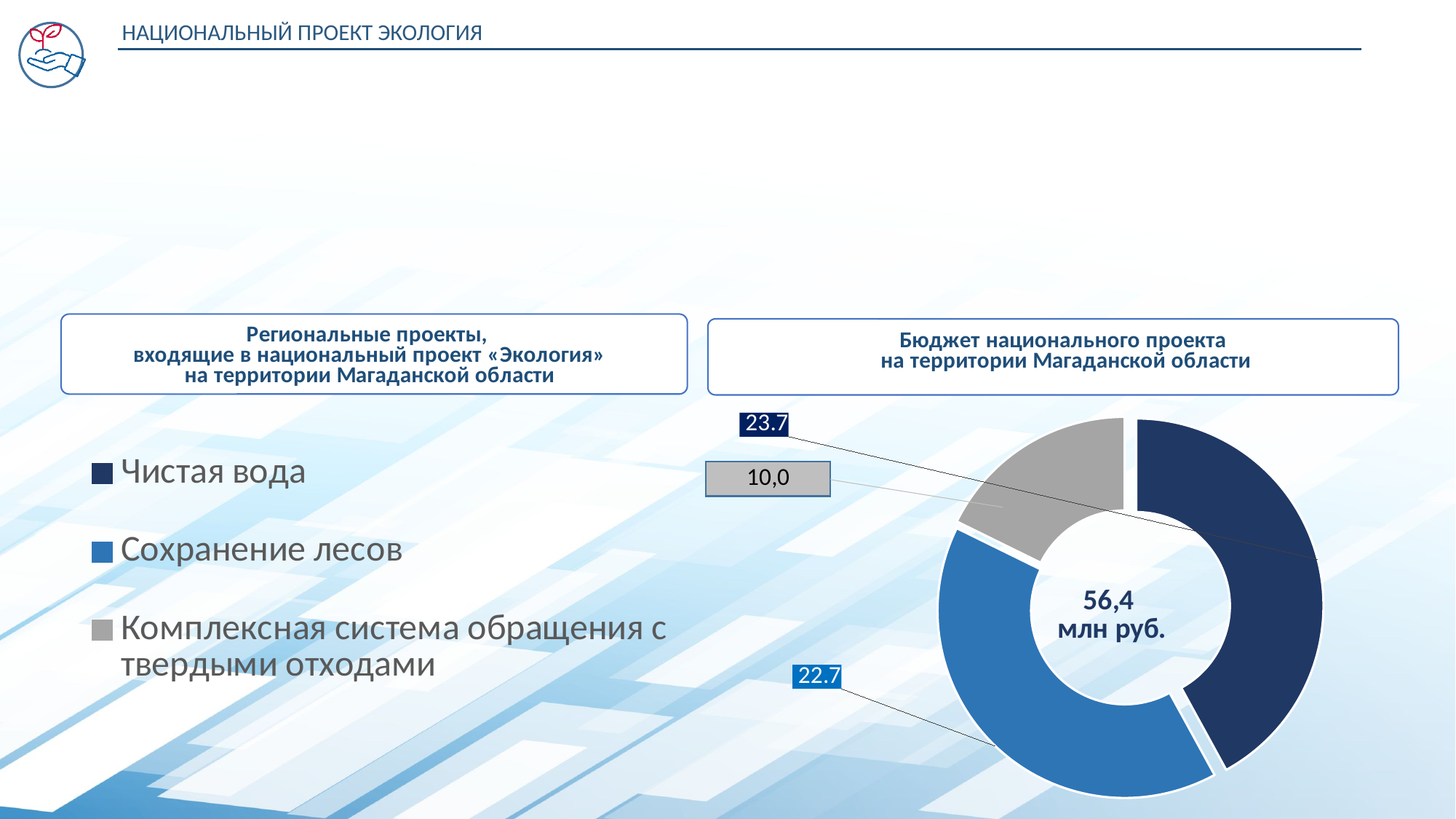
What is the difference between the values for Сохранение лесов and Комплексная система обращения с твердыми отходами? 12.7 What kind of chart is shown on the slide? Donut (pie) chart Which category has the smallest value in the donut chart? Комплексная система обращения с твердыми отходами What is the value for Комплексная система обращения с твердыми отходами in the donut chart? 10,0 What is the difference between the values for Чистая вода and Комплексная система обращения с твердыми отходами? 13.7 What is the value for Сохранение лесов in the donut chart? 22.7 What is the title of the chart on the right side of the slide? Бюджет национального проекта на территории Магаданской области Which is larger: the value for Сохранение лесов or the value for Комплексная система обращения с твердыми отходами? Сохранение лесов How many categories are shown in the donut chart? 3 What is the value for Чистая вода in the donut chart? 23.7 Which category has the largest value in the donut chart? Чистая вода What total is shown in the centre of the donut chart? 56,4 млн руб.